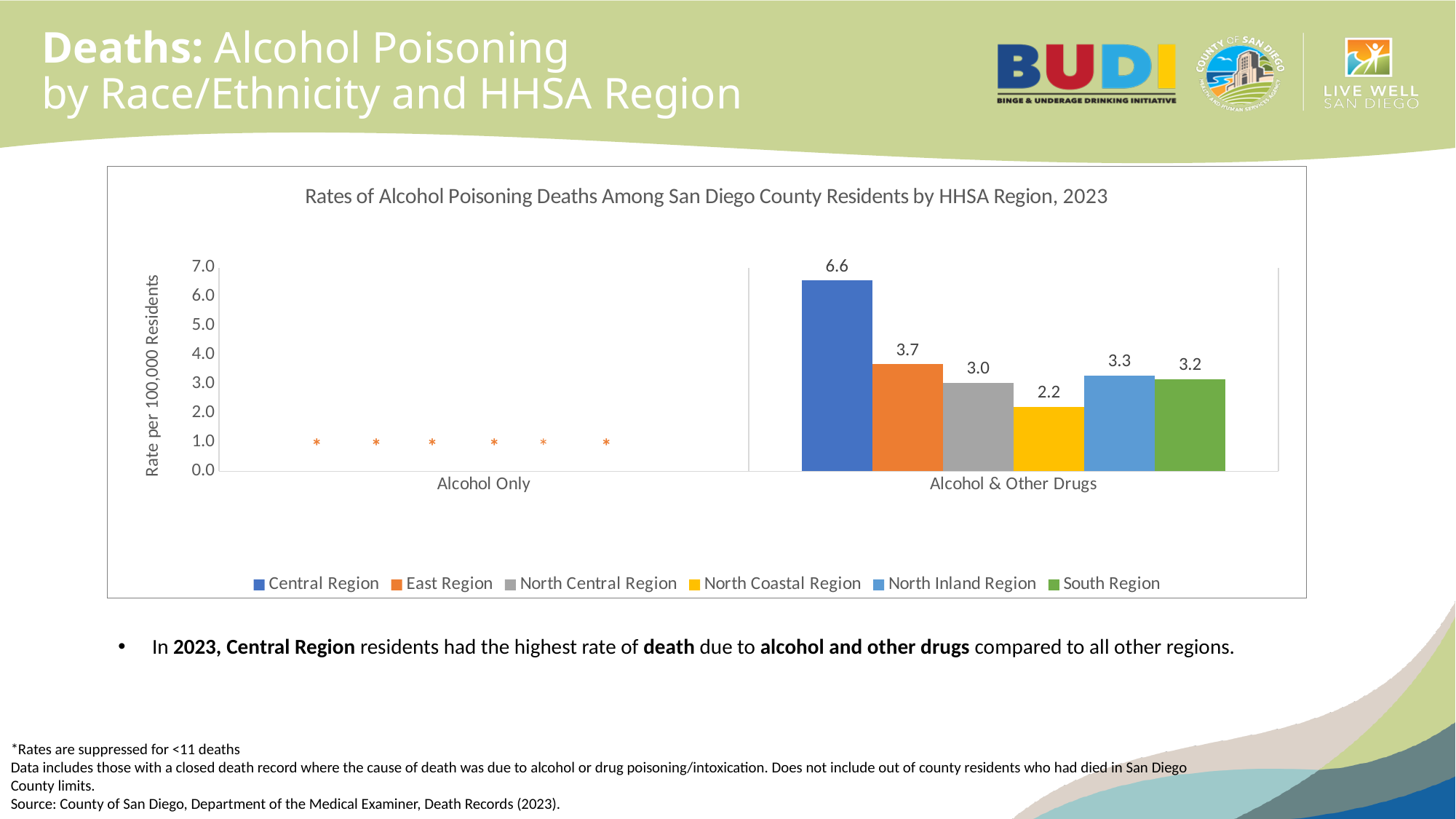
Which region has the highest rate in the Alcohol & Other Drugs category? Central Region How many regions does the legend list? 6 What is the title of the chart? Rates of Alcohol Poisoning Deaths Among San Diego County Residents by HHSA Region, 2023 What is the rate for North Inland Region in the Alcohol & Other Drugs category? 3.3 What is the label of the y-axis? Rate per 100,000 Residents What is the difference between the Central Region and East Region rates in the Alcohol & Other Drugs category? 2.9 In the Alcohol & Other Drugs category, which is larger: the rate for South Region or the rate for North Coastal Region? South Region What is the rate for Central Region in the Alcohol & Other Drugs category? 6.6 What is the rate for East Region in the Alcohol & Other Drugs category? 3.7 Which region has the lowest rate in the Alcohol & Other Drugs category? North Coastal Region What type of chart is shown on the slide? Bar chart What is the rate for North Coastal Region in the Alcohol & Other Drugs category? 2.2